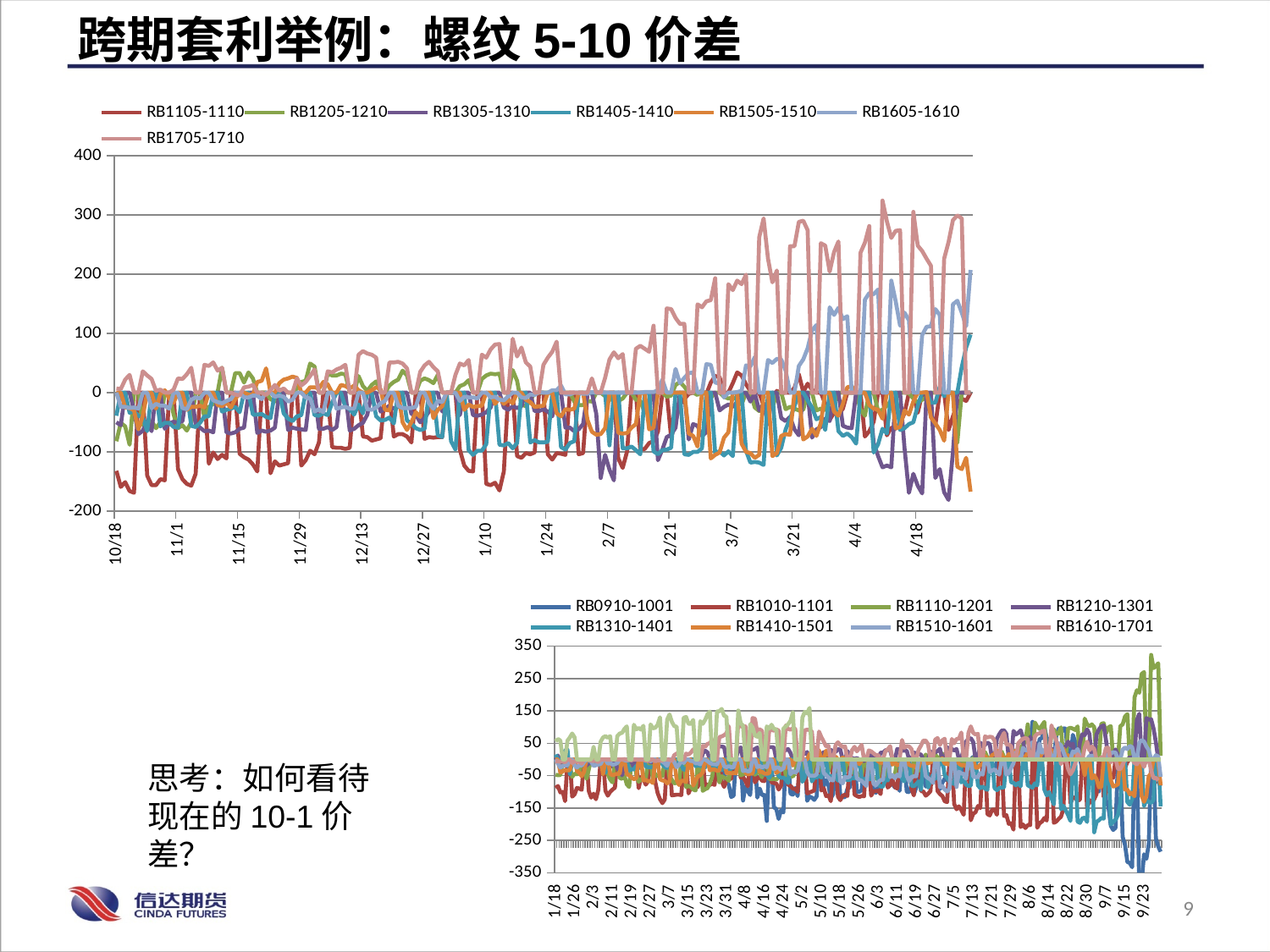
In the bottom chart, which series reaches the highest peak? RB1110-1201 In the top chart, does the RB1705-1710 series generally rise or fall from October to April? rise In the bottom chart, which series reaches the lowest value? RB0910-1001 What kind of chart is the bottom chart on the slide? line chart In the bottom chart, is the lowest value of RB0910-1001 greater or less than -250? less What kind of chart is the top chart on the slide? line chart How many series does the legend of the top chart list? 7 What is the maximum value shown on the vertical axis of the bottom chart? 350 In the top chart, is the peak value of RB1705-1710 greater or less than 300? greater How many series does the legend of the bottom chart list? 8 What is the first series listed in the legend of the top chart? RB1105-1110 In the top chart, which series reaches the highest values? RB1705-1710